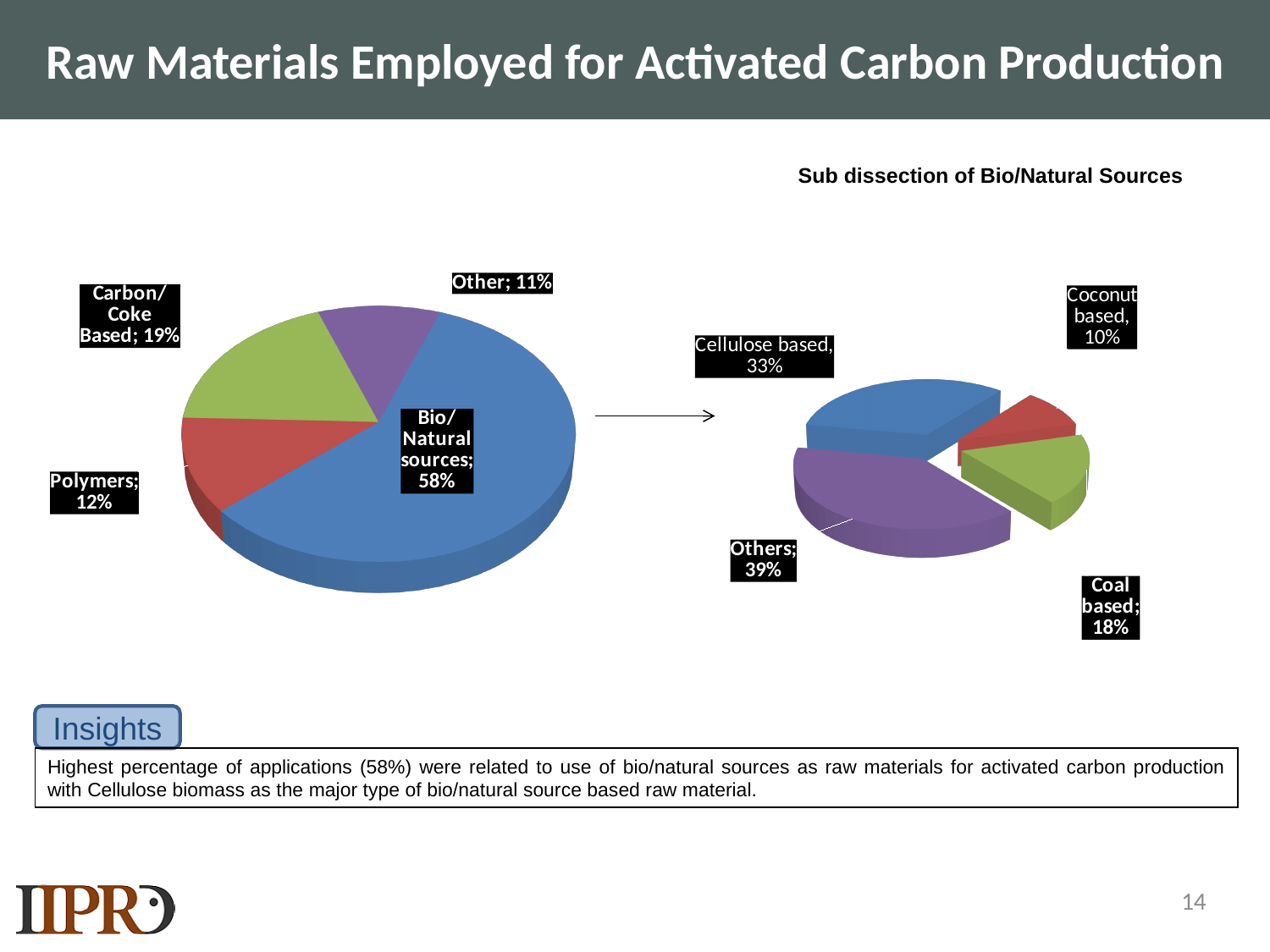
In the 'Sub dissection of Bio/Natural Sources' chart, what share is labelled for Coal based? 18% In the left pie chart, how many slices are there? 4 In the 'Sub dissection of Bio/Natural Sources' chart, which is larger, Others or Cellulose based? Others In the left pie chart, what share is labelled for Polymers? 12% What kind of chart is the 'Sub dissection of Bio/Natural Sources' chart? Pie chart In the left pie chart, what is the difference in percentage points between Bio/Natural sources and Carbon/Coke Based? 39 In the 'Sub dissection of Bio/Natural Sources' chart, what share is labelled for Cellulose based? 33% In the left pie chart, what share is labelled for Carbon/Coke Based? 19% In the left pie chart, which category has the smallest slice? Other In the left pie chart, what share is labelled for Bio/Natural sources? 58% In the 'Sub dissection of Bio/Natural Sources' chart, which category has the smallest slice? Coconut based In the left pie chart, which category has the largest slice? Bio/Natural sources